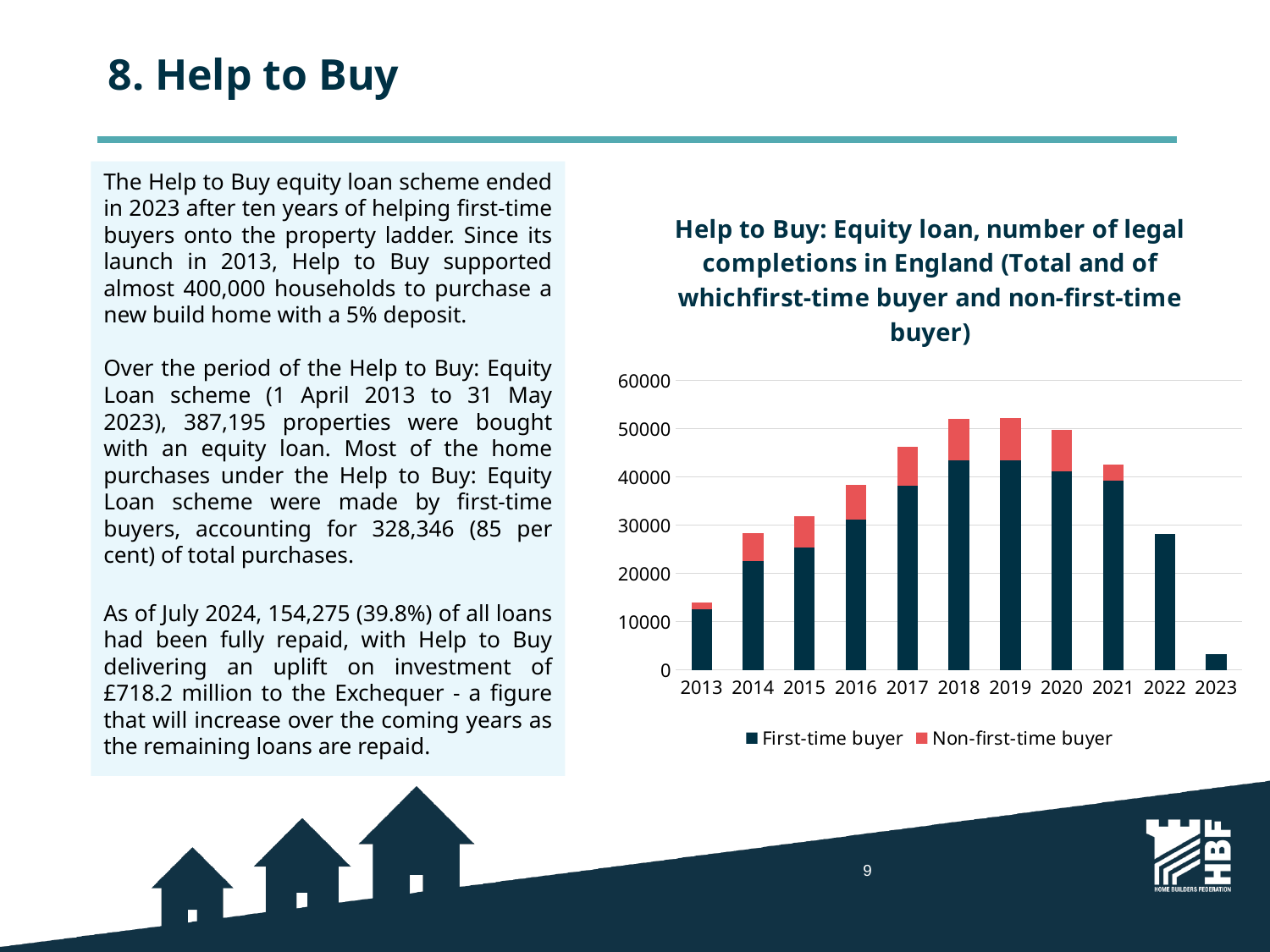
Is the total value for 2018 greater or less than 50000? greater Is the total value for 2013 greater or less than 10000? greater Is the value for 2023 greater or less than 10000? less How many years are shown on the x axis of the chart? 11 How many series does the chart's legend list? 2 Do the total completions rise or fall from 2019 to 2023? Fall Which year has the lowest total number of legal completions? 2023 What kind of chart is shown on the slide? Stacked bar chart Which series is shown in red in the chart? Non-first-time buyer Which year has the larger total number of completions, 2016 or 2017? 2017